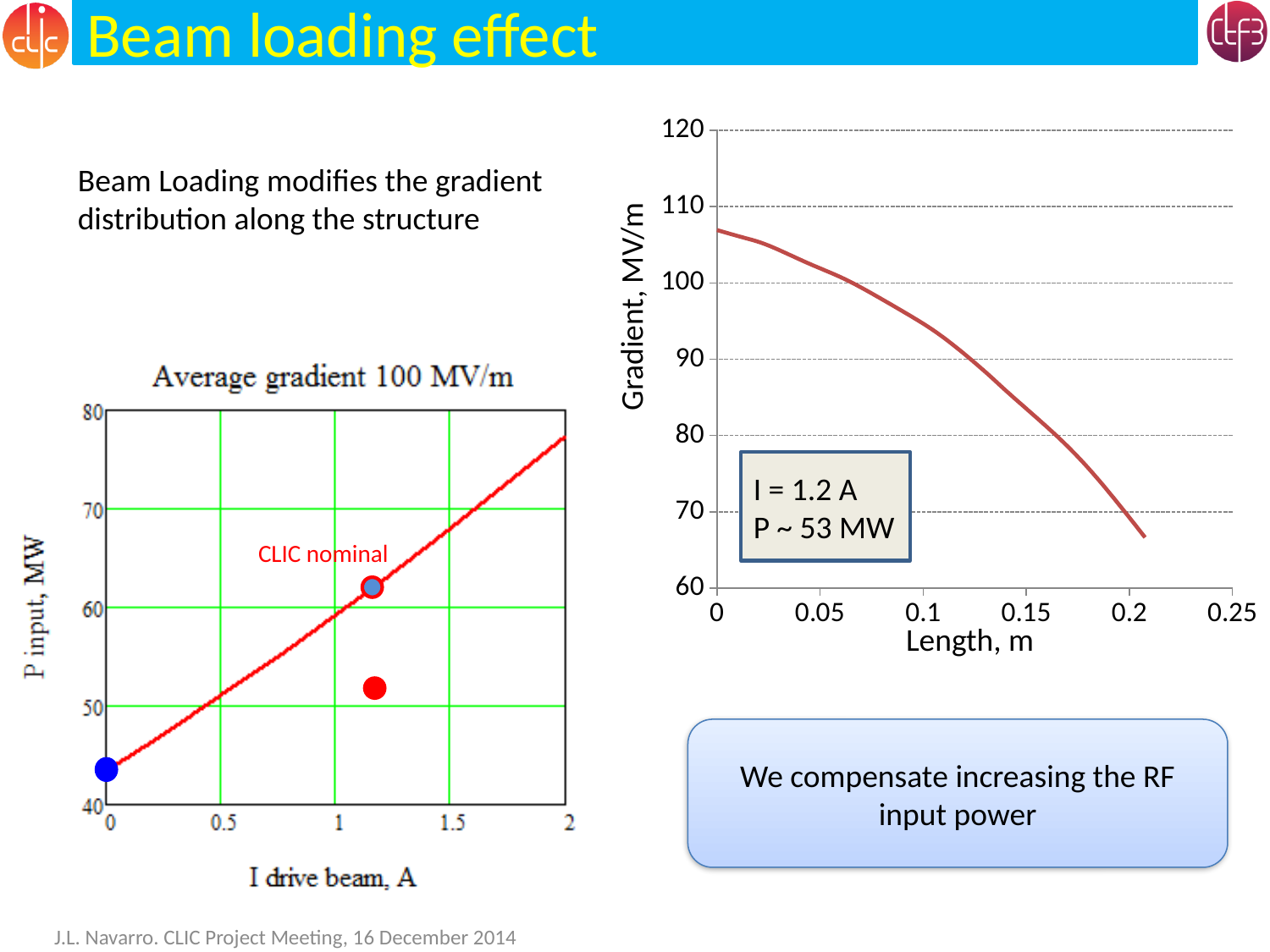
On the left-hand chart titled 'Average gradient 100 MV/m', is the input power at a drive beam current of 0 A greater or less than 50 MW? less On the left-hand chart titled 'Average gradient 100 MV/m', is the input power at the point labelled 'CLIC nominal' greater or less than 60 MW? greater On the right-hand chart (Gradient vs Length), what is the label of the vertical axis? Gradient, MV/m On the left-hand chart titled 'Average gradient 100 MV/m', does the input power rise or fall as the drive beam current increases? rise On the right-hand chart (Gradient vs Length), does the gradient rise or fall as length increases? fall On the right-hand chart (Gradient vs Length), what is the largest value shown on the horizontal axis? 0.25 On the right-hand chart (Gradient vs Length), is the gradient at length 0 m greater or less than 100 MV/m? greater On the left-hand chart titled 'Average gradient 100 MV/m', what is the label of the horizontal axis? I drive beam, A On the left-hand chart titled 'Average gradient 100 MV/m', how many individual marked points (dots) are plotted on the chart? 3 On the left-hand chart titled 'Average gradient 100 MV/m', which has the higher input power: the point labelled 'CLIC nominal' or the red dot below it? CLIC nominal On the right-hand chart (Gradient vs Length), what kind of chart is it? line chart